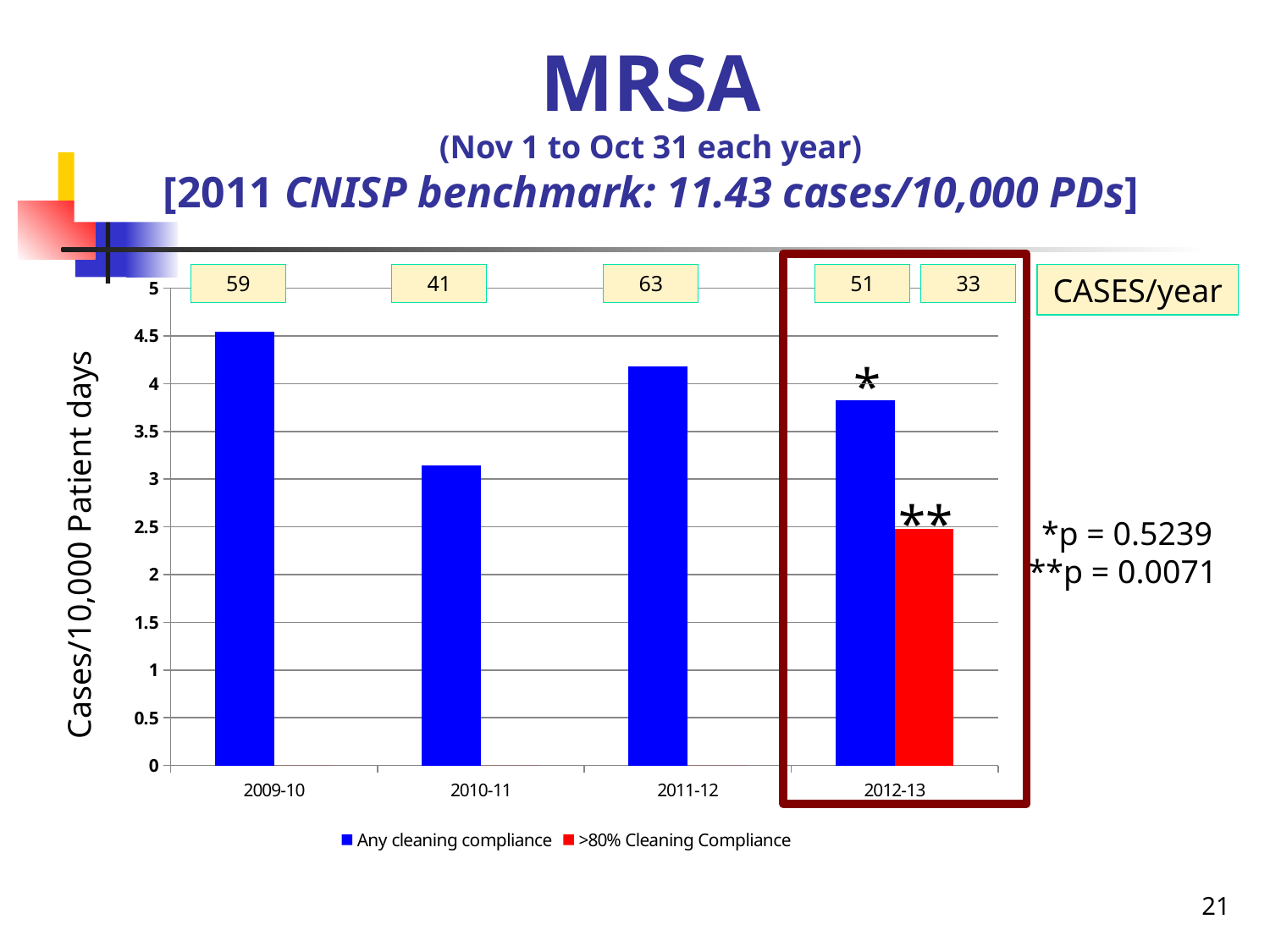
How many year categories are shown on the x axis? 4 What number of cases per year is shown in the box above the 2011-12 bar? 63 In 2012-13, which series has the larger value: Any cleaning compliance or >80% Cleaning Compliance? Any cleaning compliance Which year has the highest value for Any cleaning compliance? 2009-10 How many series does the legend list? 2 What kind of chart is shown on the slide? bar chart Which is larger, the Any cleaning compliance value for 2011-12 or for 2010-11? 2011-12 Which year has the lowest value for Any cleaning compliance? 2010-11 Is the >80% Cleaning Compliance value for 2012-13 greater or less than 3? less Is the Any cleaning compliance value for 2009-10 greater or less than 4? greater What is the label of the y axis? Cases/10,000 Patient days Is the Any cleaning compliance value for 2010-11 greater or less than 3.5? less